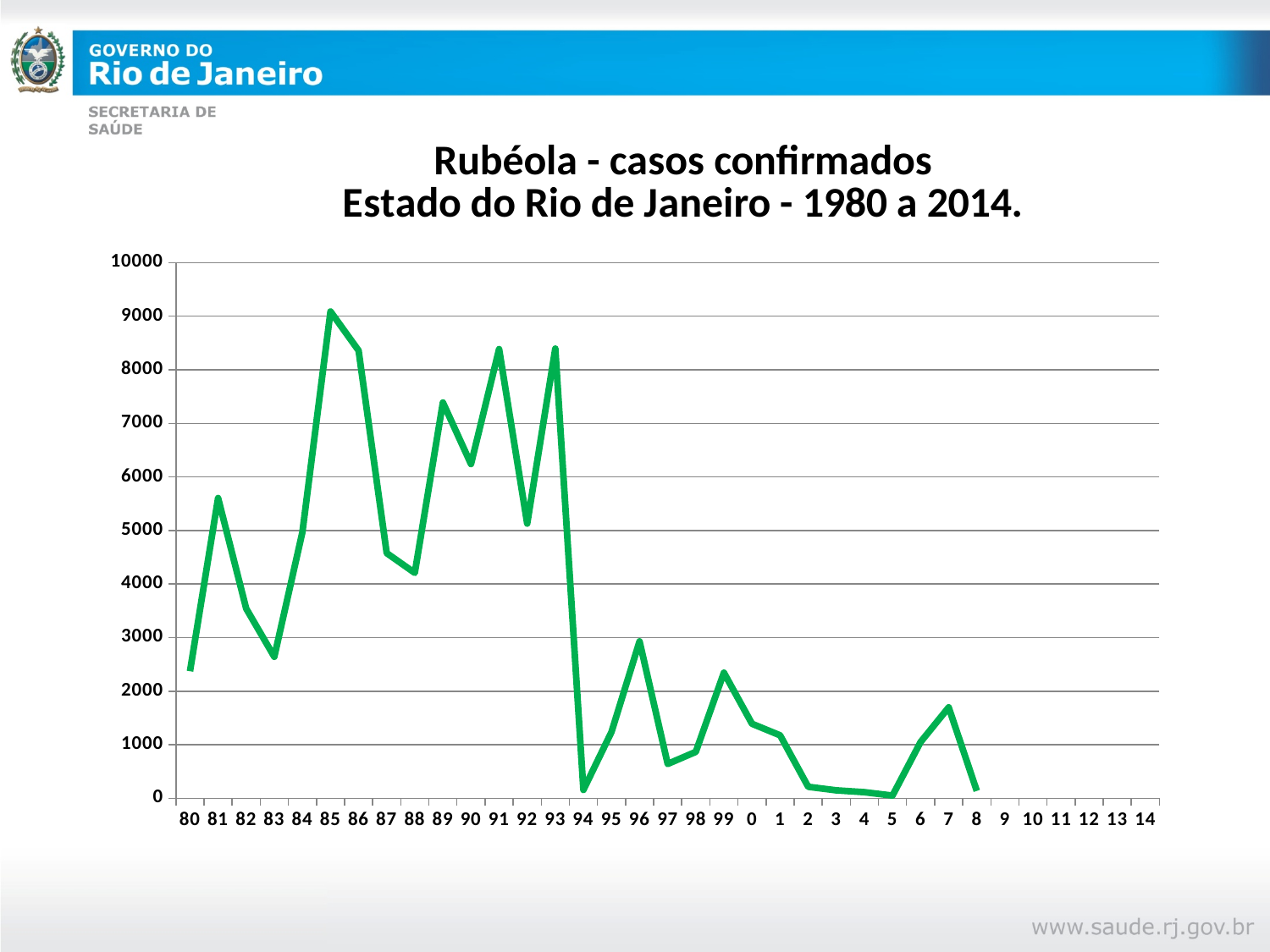
Is the value for 94 greater or less than 1000? less Is the value for 83 greater or less than 3000? less Do confirmed cases rise or fall from 93 to 94? fall In which year were confirmed rubella cases highest? 85 Which year has more confirmed cases, 89 or 90? 89 Is the value for 85 greater or less than 8000? greater Which year has more confirmed cases, 96 or 99? 96 Which year has more confirmed cases, 85 or 86? 85 What kind of chart is shown on the slide? line chart What is the title of the chart? Rubéola - casos confirmados Estado do Rio de Janeiro - 1980 a 2014.